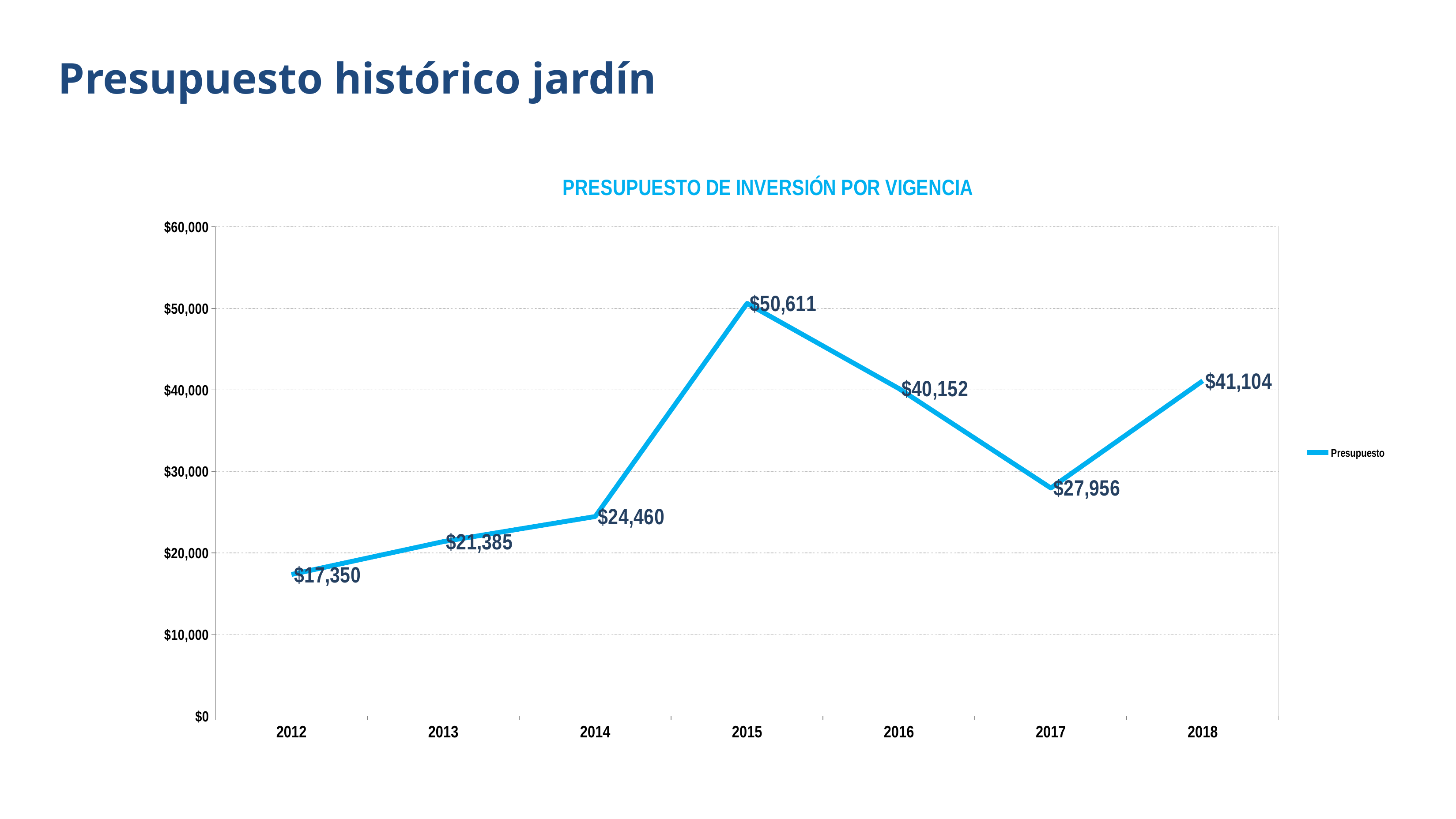
What kind of chart is shown on the slide? line chart What is the difference between the budget for 2015 and the budget for 2016? $10,459 What is the budget value for 2017? $27,956 How many years are plotted on the chart? 7 Which year has the lowest budget? 2012 Is the value for 2014 greater or less than $30,000? less Which year has the highest budget? 2015 What is the budget value for 2012? $17,350 Which year has a larger budget, 2016 or 2018? 2018 What is the title of the chart? PRESUPUESTO DE INVERSIÓN POR VIGENCIA What is the budget value for 2015? $50,611 How many series does the legend list? 1